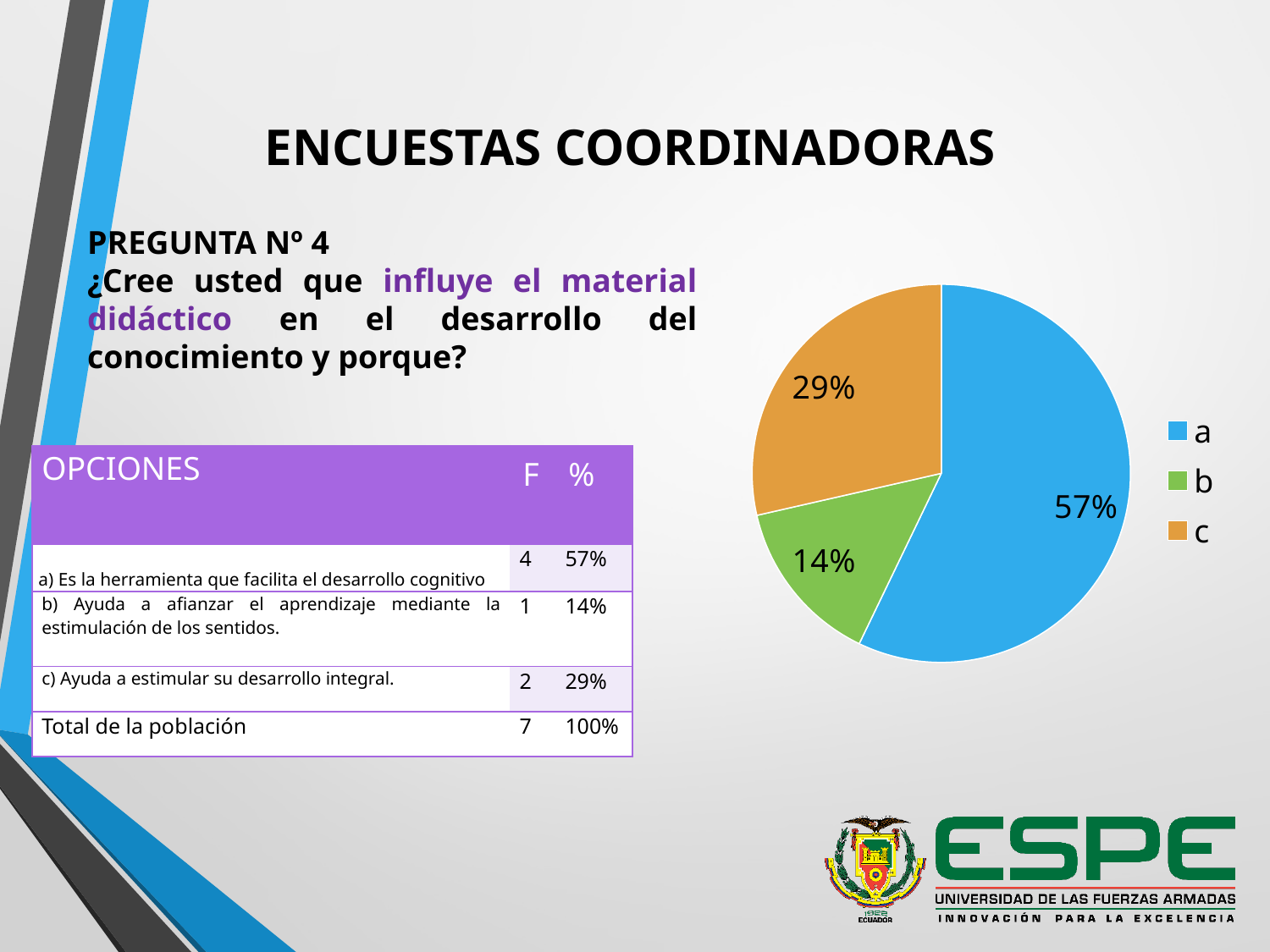
What is the difference in percentage points between slice c and slice b? 15 Which is larger in the pie chart, slice b or slice c? c What percentage does slice b represent in the pie chart? 14% How many entries does the legend of the pie chart list? 3 How many slices does the pie chart have? 3 What colour is slice c in the pie chart? orange Which slice of the pie chart is the largest? a What kind of chart is shown on the slide? pie chart Which slice of the pie chart is the smallest? b What percentage does slice c represent in the pie chart? 29% What is the difference in percentage points between slice a and slice c? 28 What percentage does slice a represent in the pie chart? 57%